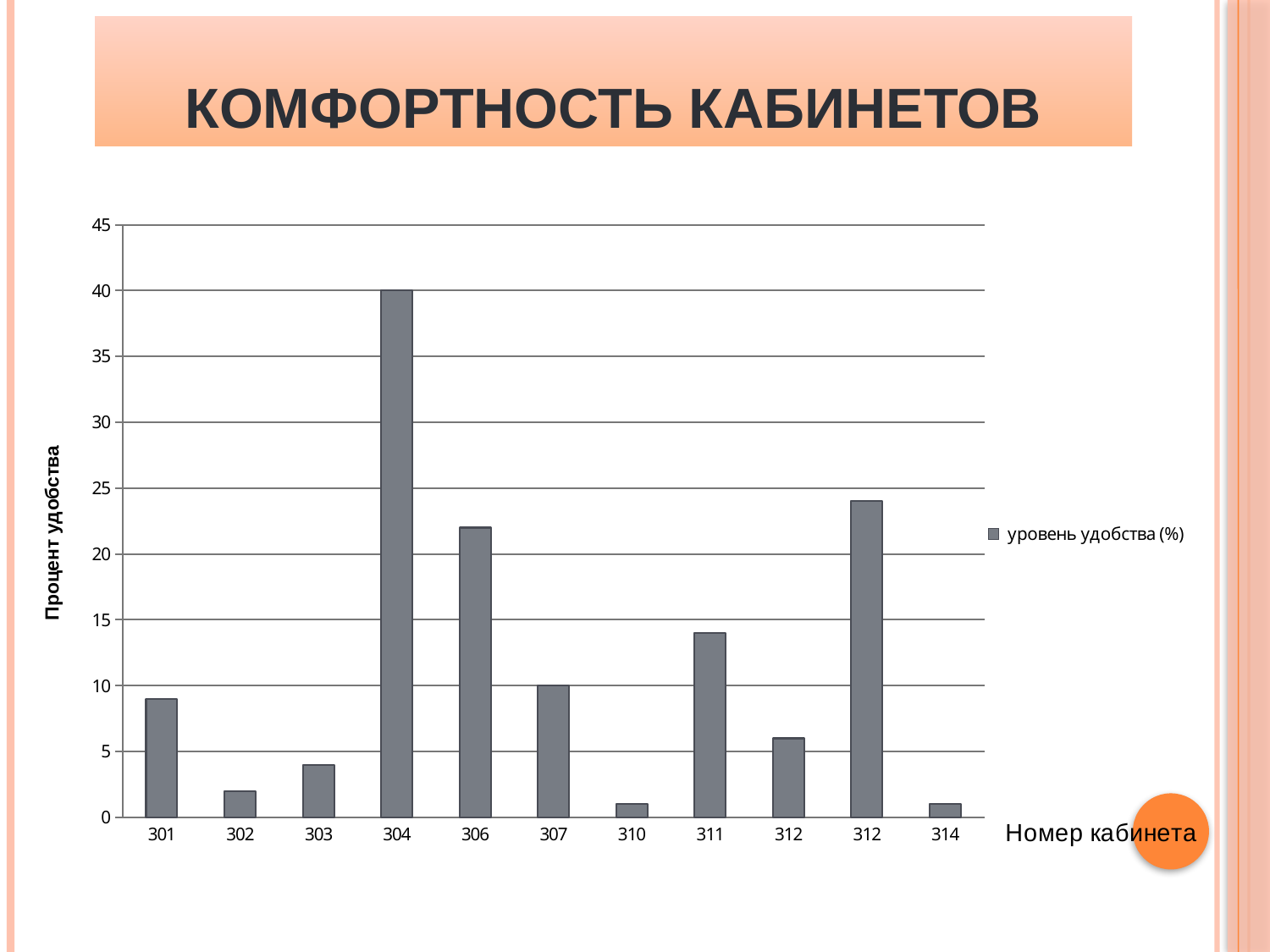
Is the value for cabinet 306 greater or less than 20? greater Which has a larger value, cabinet 304 or cabinet 306? 304 What is the value for cabinet 307? 10 Is the value for cabinet 311 greater or less than 10? greater What type of chart is shown on the slide? bar chart Which has a larger value, cabinet 311 or cabinet 303? 311 Is the value for cabinet 302 greater or less than 5? less What is the legend entry shown on the chart? уровень удобства (%) Which cabinet has the highest value? 304 What is the value for cabinet 304? 40 How many bars are plotted on the chart? 11